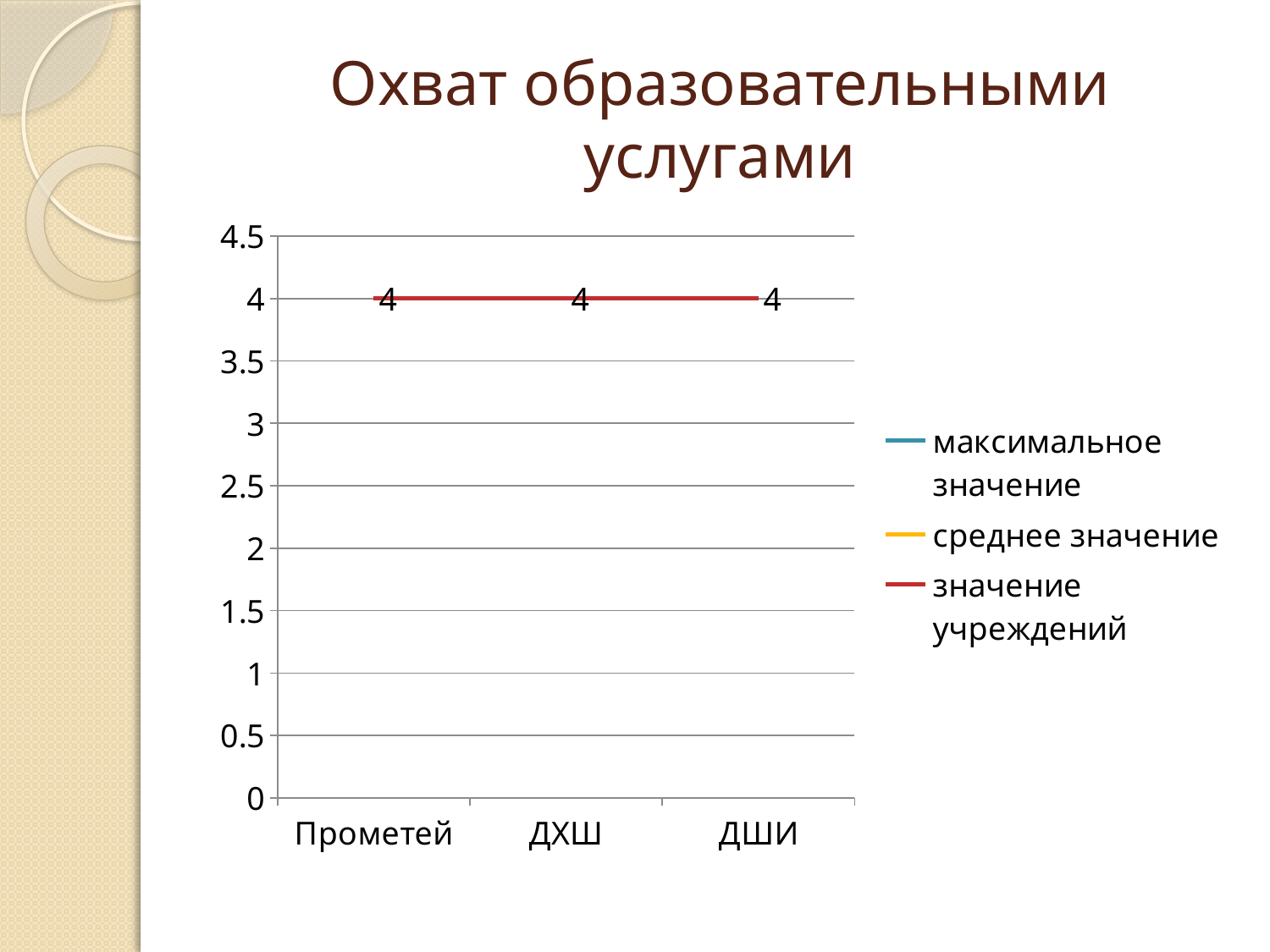
What is the value of 'значение учреждений' for ДШИ? 4 How many categories are shown on the x axis? 3 How many series does the legend list? 3 What is the difference between the values for Прометей and ДШИ? 0 What is the value of 'значение учреждений' for ДХШ? 4 What is the title of the chart? Охват образовательными услугами Is the value for ДХШ greater or less than 3.5? greater What is the highest value shown on the y axis? 4.5 What kind of chart is shown on the slide? line chart What is the value of 'значение учреждений' for Прометей? 4 Do the values of 'значение учреждений' rise, fall or stay the same from Прометей to ДШИ? stay the same What colour is the line for 'значение учреждений'? red